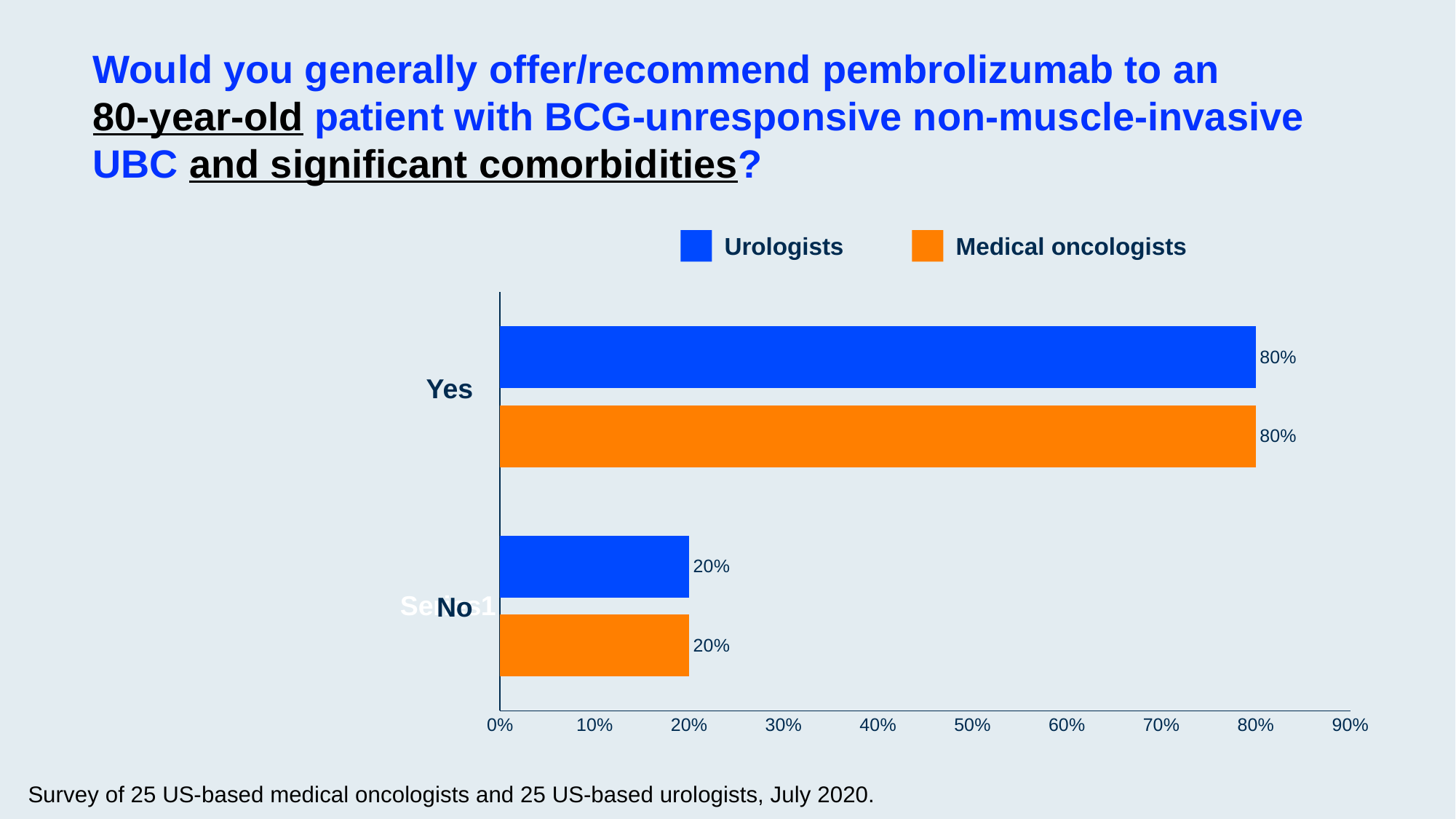
What percentage of urologists answered No? 20% What percentage of medical oncologists answered Yes? 80% Which response category has the lowest value for medical oncologists? No What percentage of medical oncologists answered No? 20% Which colour represents medical oncologists in the chart? Orange How many response categories are shown on the chart? 2 What percentage of urologists answered Yes? 80% What kind of chart is shown on the slide? Bar chart How many series does the legend list? 2 Which is larger for medical oncologists: the Yes value or the No value? Yes What is the difference between the Yes and No percentages for urologists? 60% Which response category has the highest value for urologists? Yes